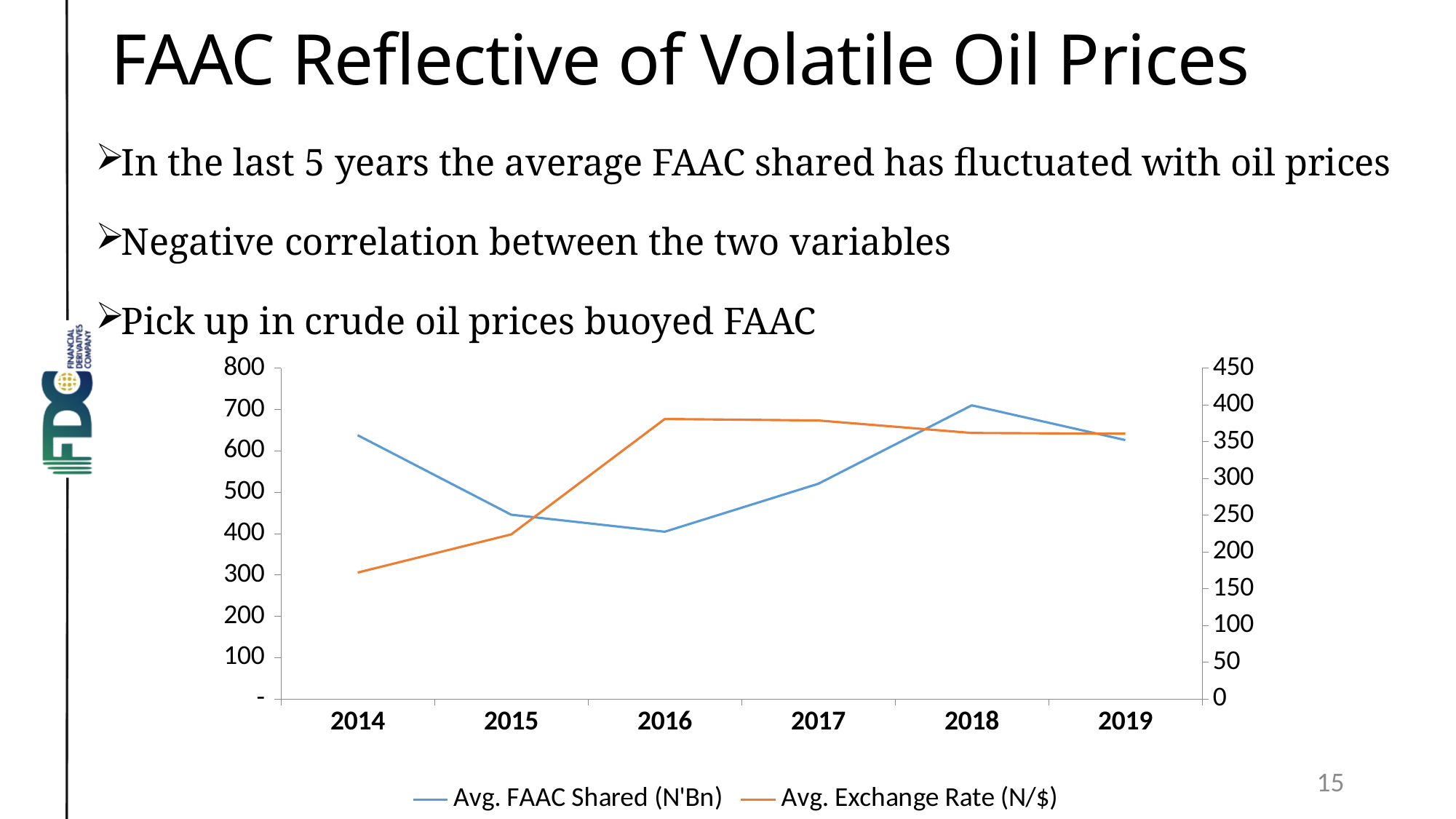
Is the value for Avg. Exchange Rate (N/$) in 2014 greater or less than 200? less Is the value for Avg. FAAC Shared (N'Bn) in 2018 greater or less than 600? greater Does Avg. Exchange Rate (N/$) rise or fall from 2014 to 2016? Rise Is the value for Avg. Exchange Rate (N/$) in 2016 greater or less than 300? greater In which year is Avg. FAAC Shared (N'Bn) highest? 2018 In which year is Avg. FAAC Shared (N'Bn) lowest? 2016 In which year is Avg. Exchange Rate (N/$) lowest? 2014 Which year has the larger Avg. FAAC Shared (N'Bn), 2014 or 2015? 2014 How many series does the chart legend list? 2 How many years are plotted along the x axis of the chart? 6 What kind of chart is shown on the slide? Line chart